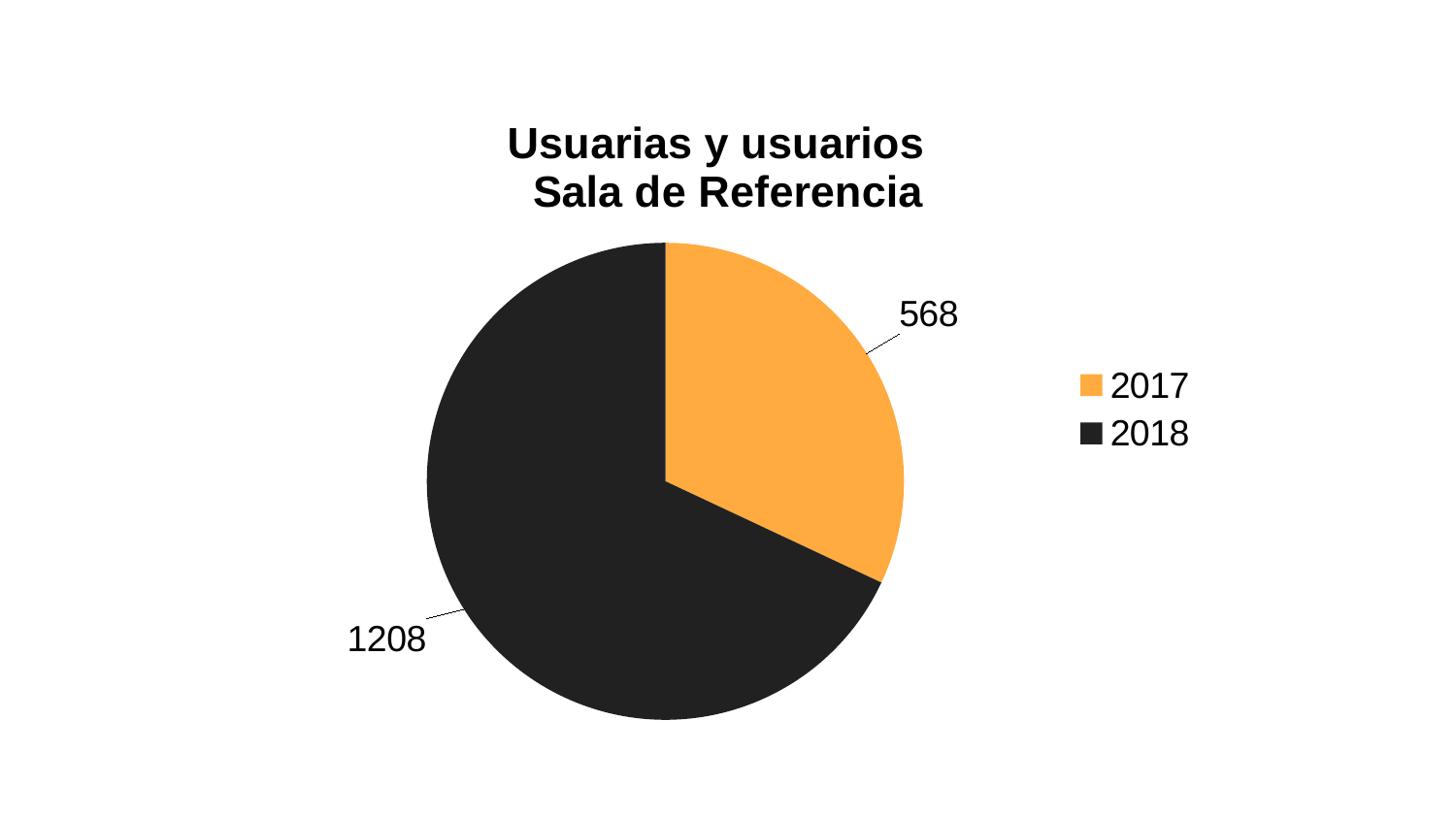
Which is larger, the value for 2017 or the value for 2018? 2018 What is the value for 2018? 1208 Which year has the largest slice? 2018 How many entries does the legend list? 2 Which year has the smallest slice? 2017 What is the difference between the values for 2018 and 2017? 640 How many slices does the pie chart have? 2 What share of the pie does the 2018 slice represent, to the nearest percent? 68% What is the value for 2017? 568 What type of chart is shown on the slide? Pie chart What is the title of the chart? Usuarias y usuarios Sala de Referencia What is the total of the two slices? 1776